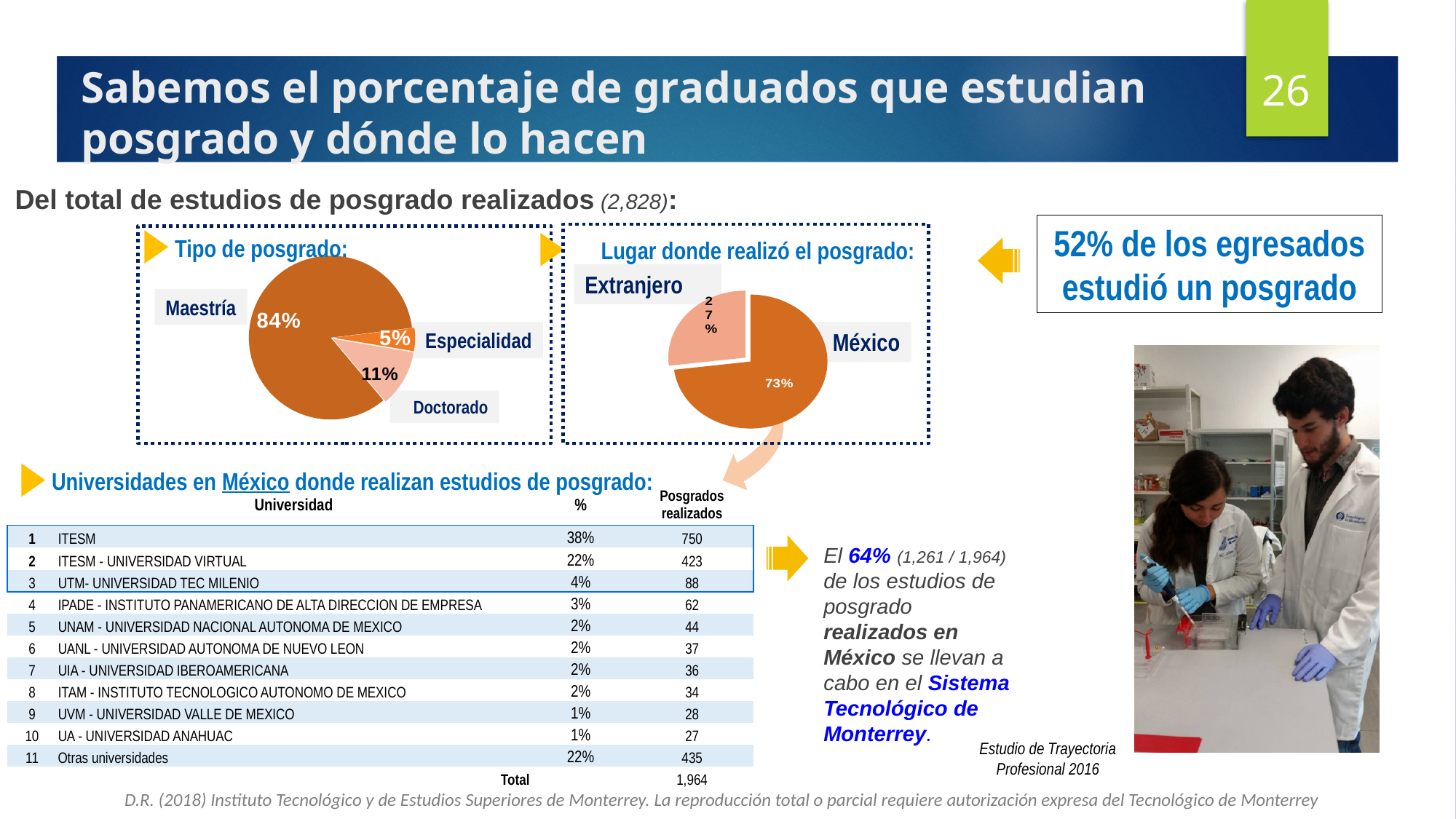
In the 'Tipo de posgrado' pie chart, what is the difference between the Maestría and Doctorado shares? 73% What type of chart is used for 'Lugar donde realizó el posgrado'? Pie chart In the 'Tipo de posgrado' pie chart, what percentage corresponds to Maestría? 84% In the 'Lugar donde realizó el posgrado' pie chart, what is the difference between the México and Extranjero shares? 46% In the 'Tipo de posgrado' pie chart, which category has the largest share? Maestría In the 'Lugar donde realizó el posgrado' pie chart, what percentage corresponds to Extranjero? 27% In the 'Tipo de posgrado' pie chart, what percentage corresponds to Especialidad? 5% In the 'Lugar donde realizó el posgrado' pie chart, what percentage corresponds to México? 73% In the 'Tipo de posgrado' pie chart, how many categories are shown? 3 In the 'Tipo de posgrado' pie chart, what percentage corresponds to Doctorado? 11% In the 'Tipo de posgrado' pie chart, which category has the smallest share? Especialidad In the 'Lugar donde realizó el posgrado' pie chart, which is larger, México or Extranjero? México